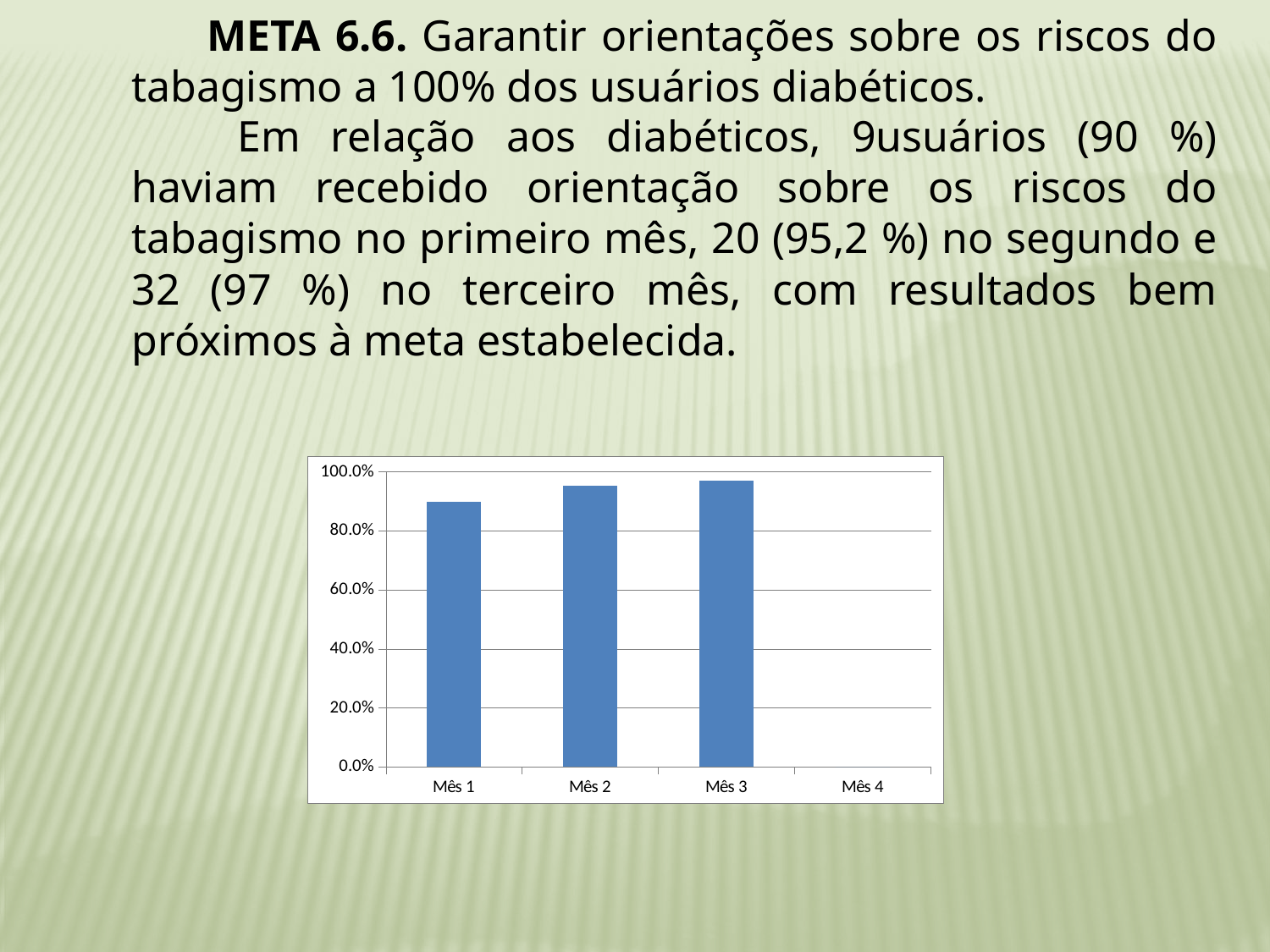
Among the months with a plotted bar, which has the lowest value? Mês 1 Is the value for Mês 2 greater or less than 80.0%? greater Is the value for Mês 3 greater or less than 60.0%? greater What is the highest tick value shown on the y axis? 100.0% How many categories are labelled on the x axis of the chart? 4 Which is larger, the bar for Mês 1 or the bar for Mês 3? Mês 3 Is the value for Mês 1 greater or less than 80.0%? greater Which category on the x axis has no bar plotted? Mês 4 Do the bar values rise or fall from Mês 1 to Mês 3? rise What kind of chart is shown on the slide? bar chart